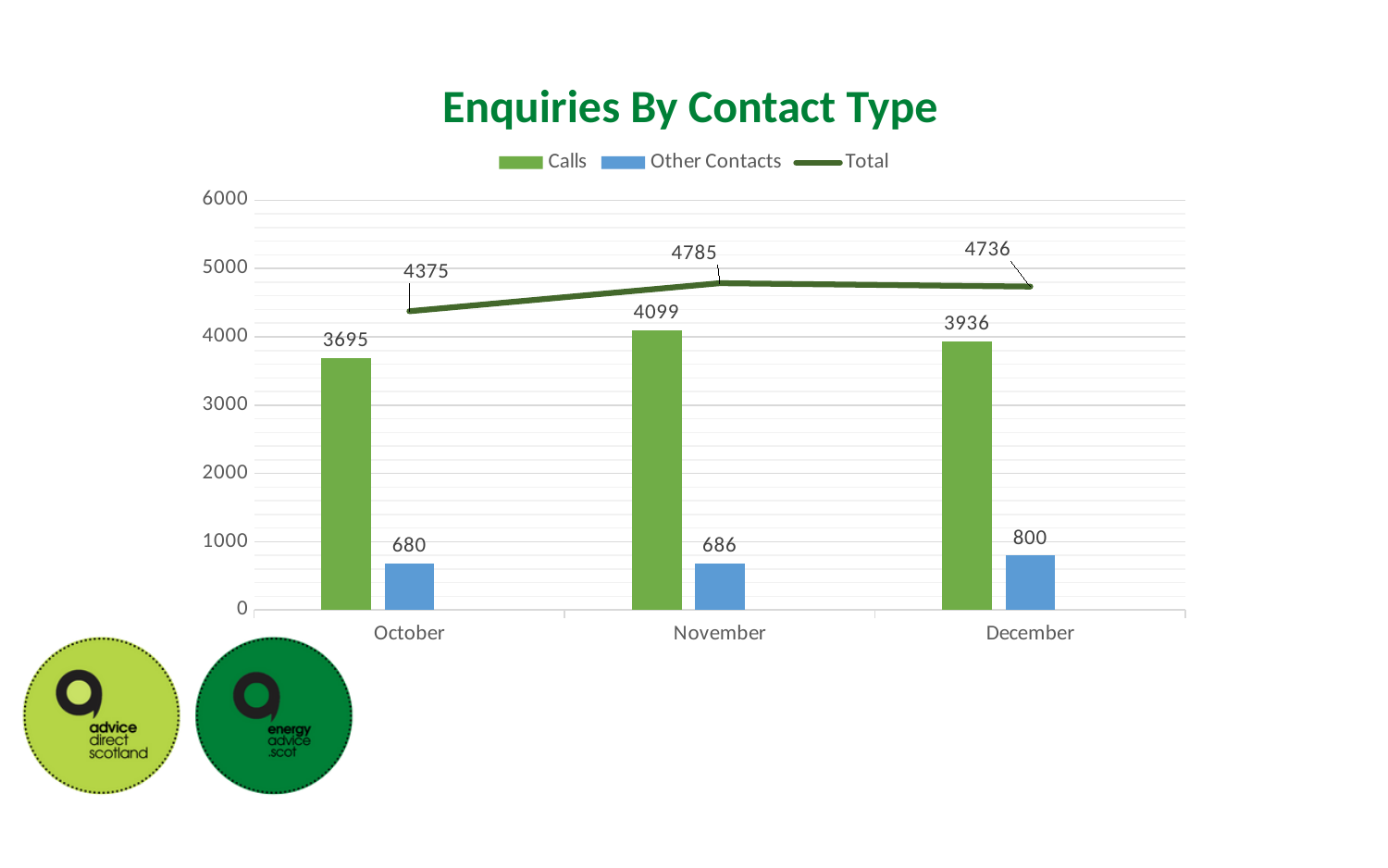
What is the Total for October? 4375 How many months are shown on the x axis? 3 What is the difference between Calls in November and Calls in December? 163 Which is larger: Other Contacts in October or Other Contacts in December? December How many series does the legend list? 3 Is the value for Calls in October greater or less than 3000? greater Which month has the highest number of Calls? November What is the value for Other Contacts in December? 800 What is the value for Calls in November? 4099 What is the title of the chart? Enquiries By Contact Type Which month has the lowest Total? October What kind of chart is this? Combined bar and line chart